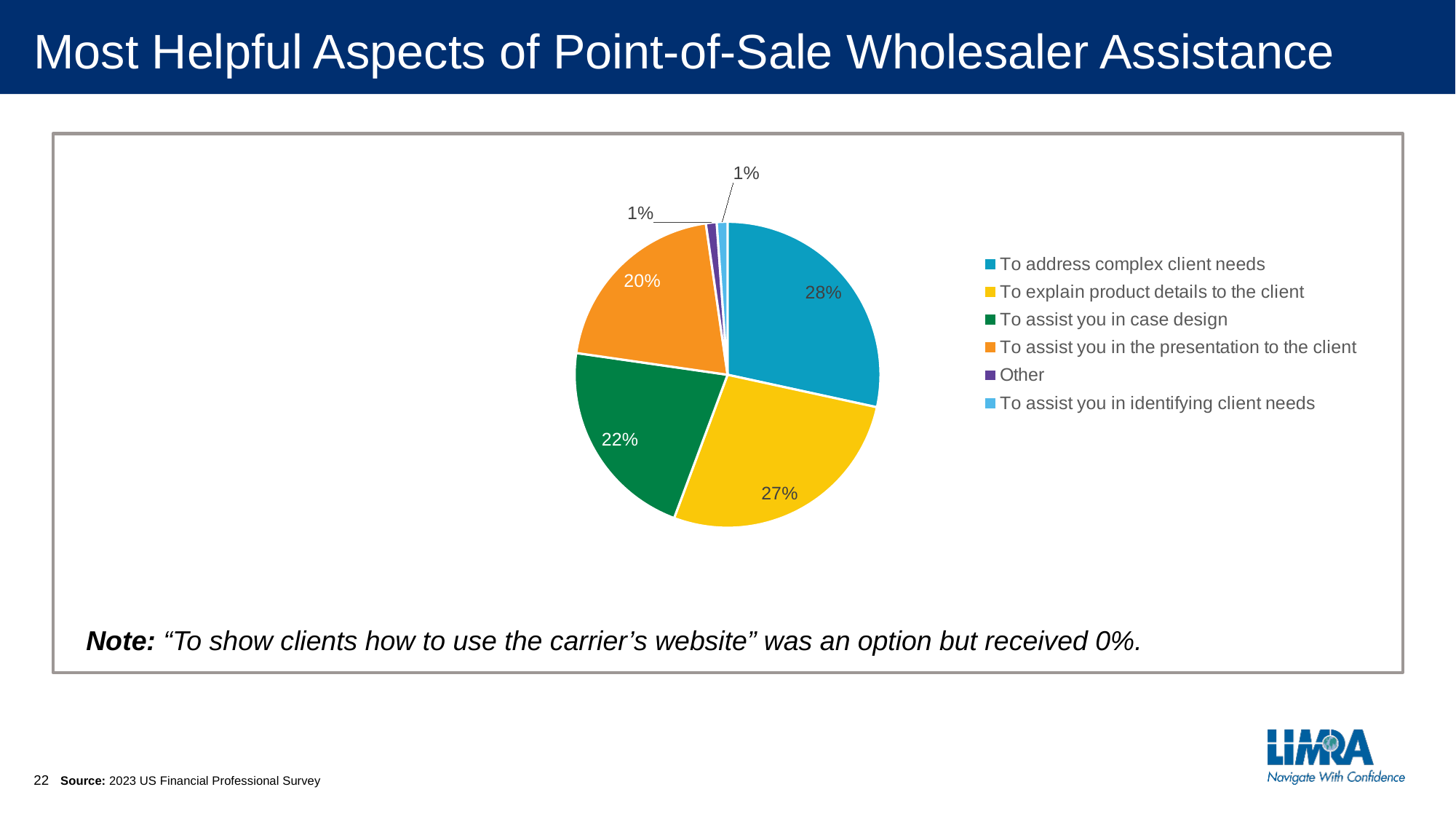
What is the difference between the shares for "To address complex client needs" and "To assist you in the presentation to the client"? 8% Which category has the largest share of the pie? To address complex client needs What percentage is shown for "To address complex client needs"? 28% What percentage is shown for "To assist you in case design"? 22% Which is larger: the share for "To assist you in case design" or the share for "To assist you in the presentation to the client"? To assist you in case design What percentage is shown for "To assist you in the presentation to the client"? 20% What is the combined share of "To address complex client needs" and "To explain product details to the client"? 55% What percentage is shown for "To explain product details to the client"? 27% What colour is the slice for "To assist you in case design"? green How many categories does the legend list? 6 What kind of chart is shown on the slide? pie chart What percentage is shown for "Other"? 1%